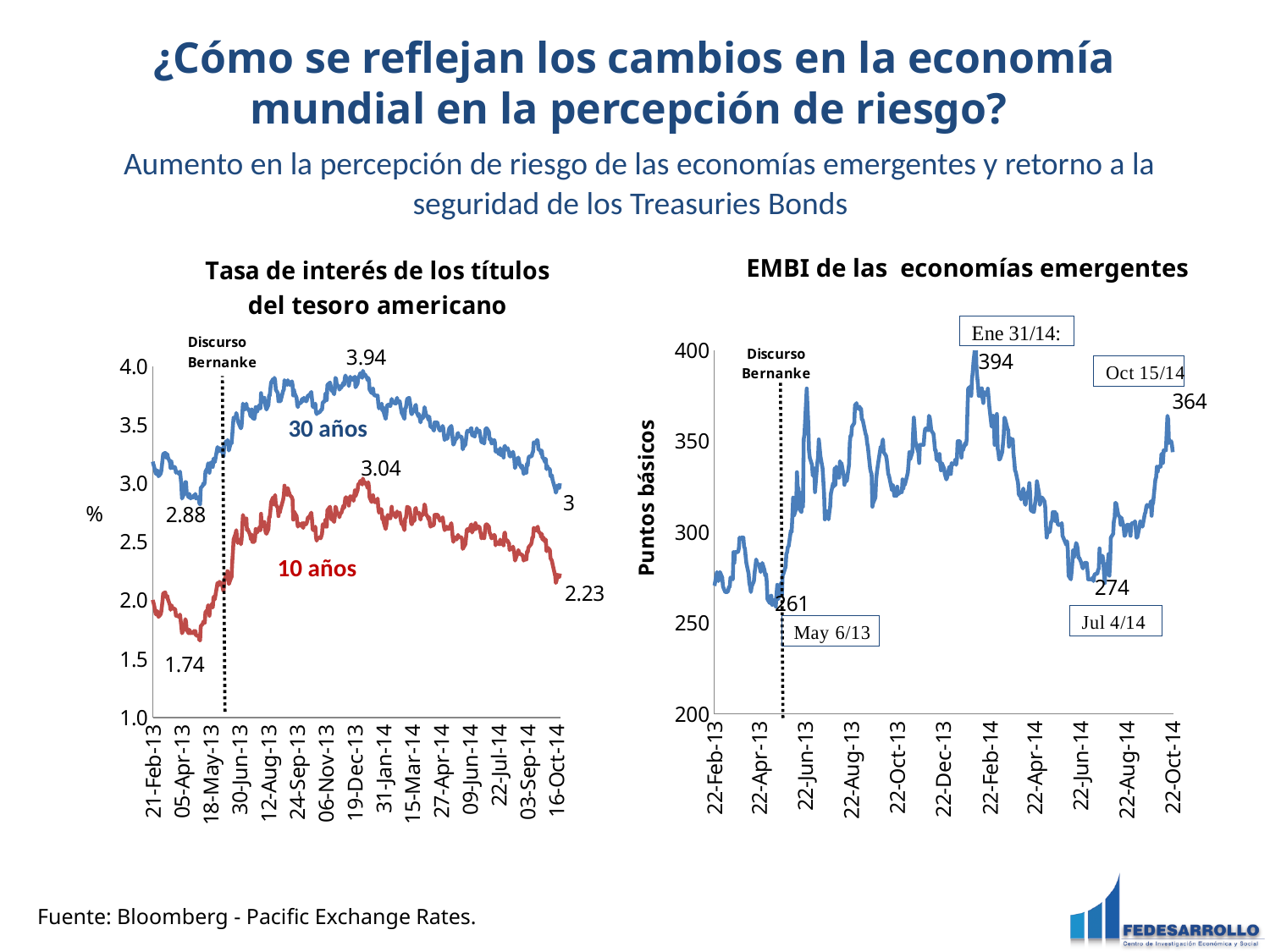
In the 'Tasa de interés de los títulos del tesoro americano' chart, what value is labelled at the end of the '10 años' series? 2.23 How many series are plotted in the 'Tasa de interés de los títulos del tesoro americano' chart? 2 In the 'EMBI de las economías emergentes' chart, what value is labelled at Jul 4/14? 274 In the 'Tasa de interés de los títulos del tesoro americano' chart, which series is plotted higher throughout, '30 años' or '10 años'? 30 años What type of chart is the 'Tasa de interés de los títulos del tesoro americano' chart? line chart In the 'Tasa de interés de los títulos del tesoro americano' chart, what is the peak value labelled on the '10 años' series? 3.04 What is the y-axis label of the 'EMBI de las economías emergentes' chart? Puntos básicos In the 'EMBI de las economías emergentes' chart, what is the difference between the value at Ene 31/14 (394) and the value at May 6/13 (261)? 133 In the 'EMBI de las economías emergentes' chart, is the value at Oct 15/14 greater or less than 350? greater In the 'Tasa de interés de los títulos del tesoro americano' chart, what is the difference between the labelled peak of the '30 años' series (3.94) and the labelled peak of the '10 años' series (3.04)? 0.90 In the 'Tasa de interés de los títulos del tesoro americano' chart, what is the peak value labelled on the '30 años' series? 3.94 In the 'EMBI de las economías emergentes' chart, what value is labelled at Ene 31/14? 394